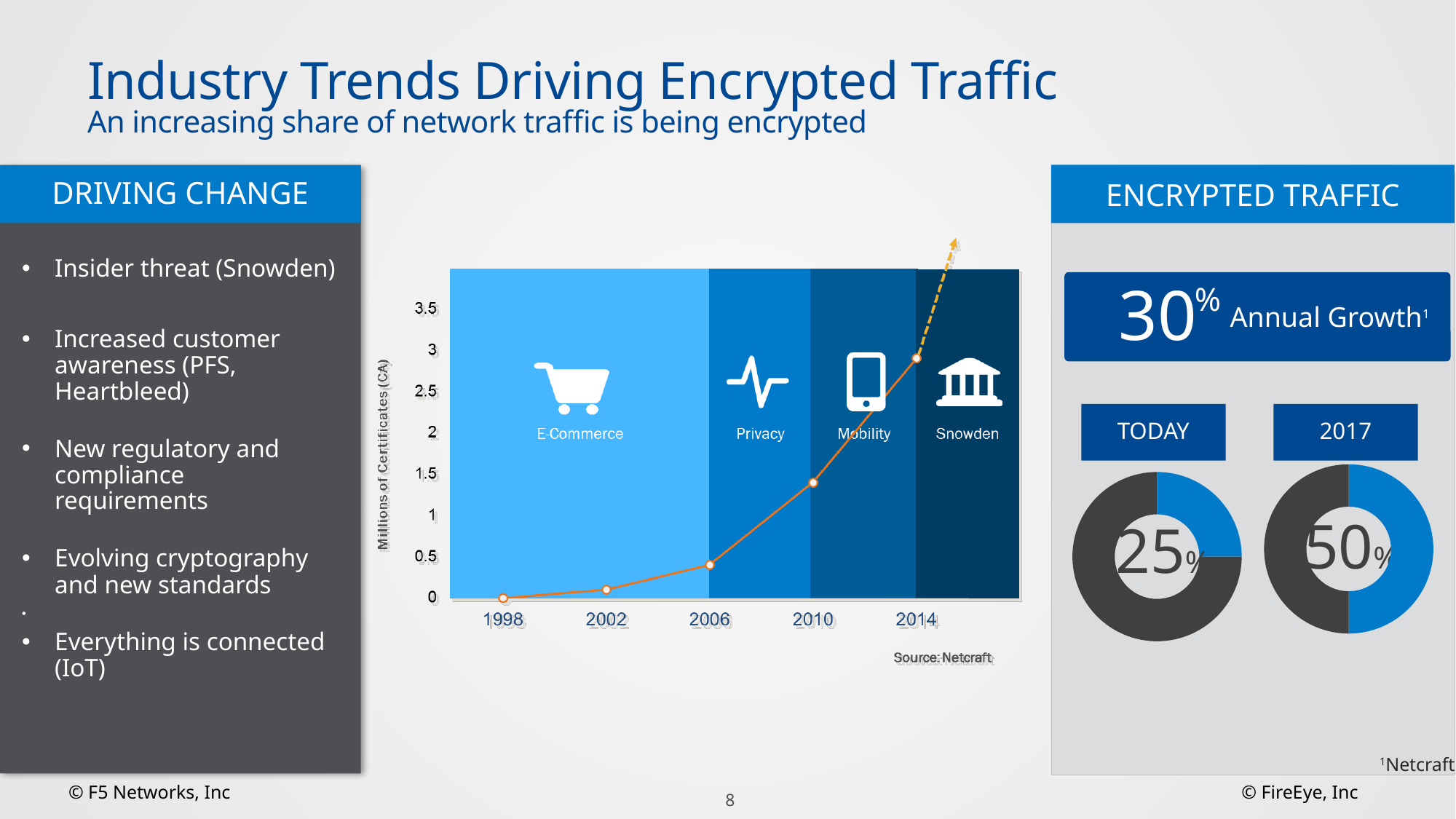
What kind of chart is the chart in the middle of the slide showing Millions of Certificates (CA)? line chart In the Millions of Certificates (CA) line chart, do the values rise or fall from 1998 to 2014? rise In the Millions of Certificates (CA) line chart, which year has the lowest value? 1998 In the ENCRYPTED TRAFFIC panel, what share of traffic is encrypted in the 2017 donut chart? 50% In the Millions of Certificates (CA) line chart, which year has the highest value? 2014 In the Millions of Certificates (CA) line chart, how many years are labelled on the x axis? 5 In the Millions of Certificates (CA) line chart, is the value for 2010 greater or less than 1? greater In the Millions of Certificates (CA) line chart, is the value for 2002 greater or less than 0.5? less In the ENCRYPTED TRAFFIC panel, what is the difference in percentage points between the 2017 donut chart value and the TODAY donut chart value? 25 In the ENCRYPTED TRAFFIC panel, what share of traffic is encrypted in the TODAY donut chart? 25% In the Millions of Certificates (CA) line chart, is the value for 2014 greater or less than 2.5? greater In the Millions of Certificates (CA) line chart, which year has the larger value, 2006 or 2010? 2010